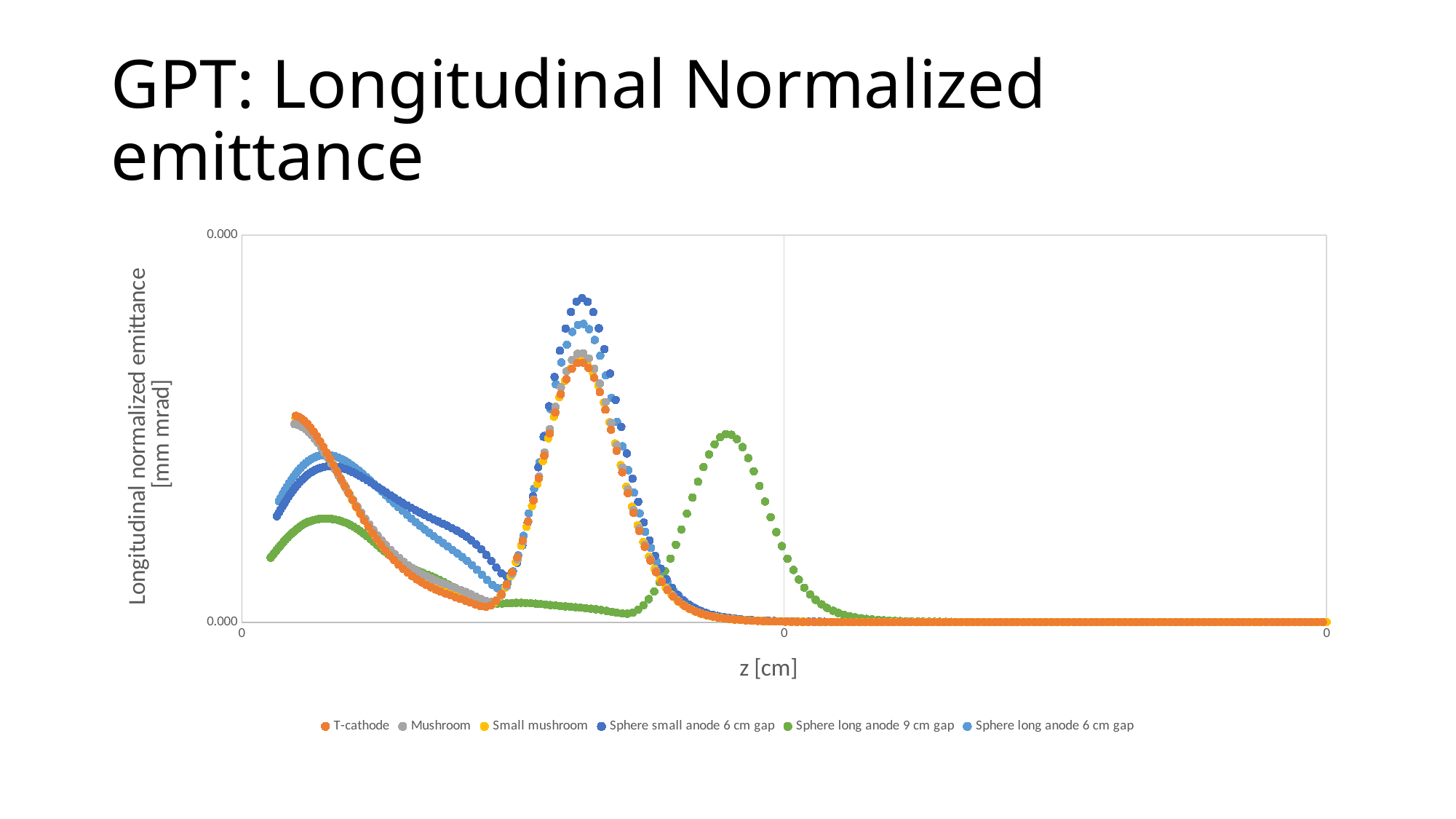
Which series has a higher peak: Sphere small anode 6 cm gap or Sphere long anode 9 cm gap? Sphere small anode 6 cm gap Which series has a higher peak: T-cathode or Sphere long anode 9 cm gap? T-cathode Toward the right end of the z axis, do the values of all series rise or fall? Fall Which series is plotted in green? Sphere long anode 9 cm gap Which series has its peak furthest to the right along the z axis? Sphere long anode 9 cm gap What is the label of the x axis? z [cm] Which series has the lowest peak value on the chart? Sphere long anode 9 cm gap Which series reaches the highest peak value on the chart? Sphere small anode 6 cm gap Which series has a higher peak: Sphere small anode 6 cm gap or Sphere long anode 6 cm gap? Sphere small anode 6 cm gap How many series does the legend list? 6 What kind of chart is shown on the slide? Scatter chart